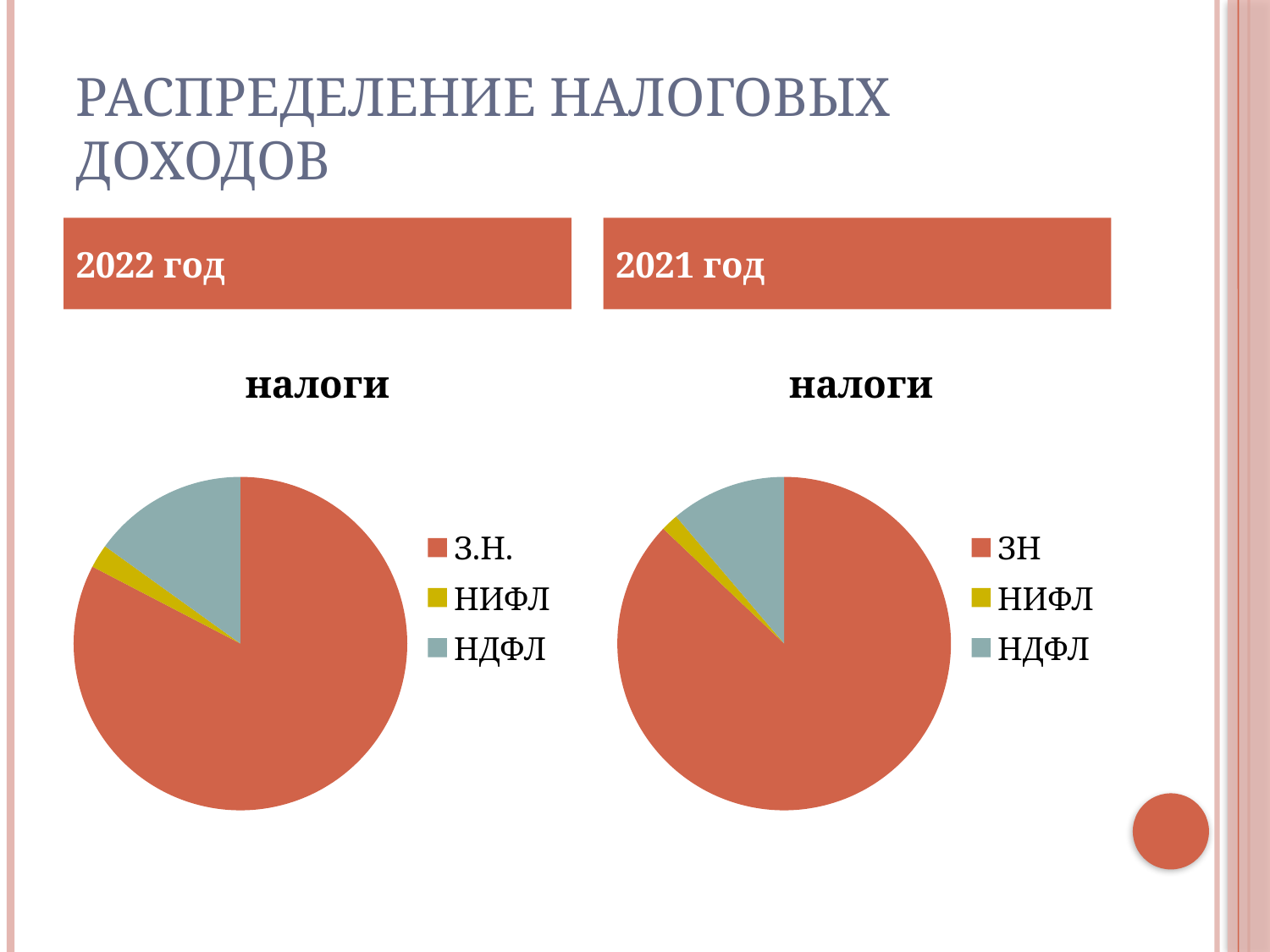
How many entries does the legend of the 2021 год pie chart list? 3 What kind of chart is shown under the 2022 год heading? pie chart In the 2021 год pie chart, which category has the largest slice? ЗН In the 2021 год pie chart, which category has the smallest slice? НИФЛ In the 2022 год pie chart, which category has the largest slice? З.Н. In the 2021 год pie chart, which slice is larger: ЗН or НДФЛ? ЗН What is the title of the pie chart under the 2021 год heading? налоги How many slices does the 2022 год pie chart have? 3 In the 2022 год pie chart, which category has the smallest slice? НИФЛ In the 2022 год pie chart, which slice is larger: НДФЛ or НИФЛ? НДФЛ What kind of chart is shown under the 2021 год heading? pie chart In the 2022 год pie chart, what colour is the НИФЛ slice? yellow